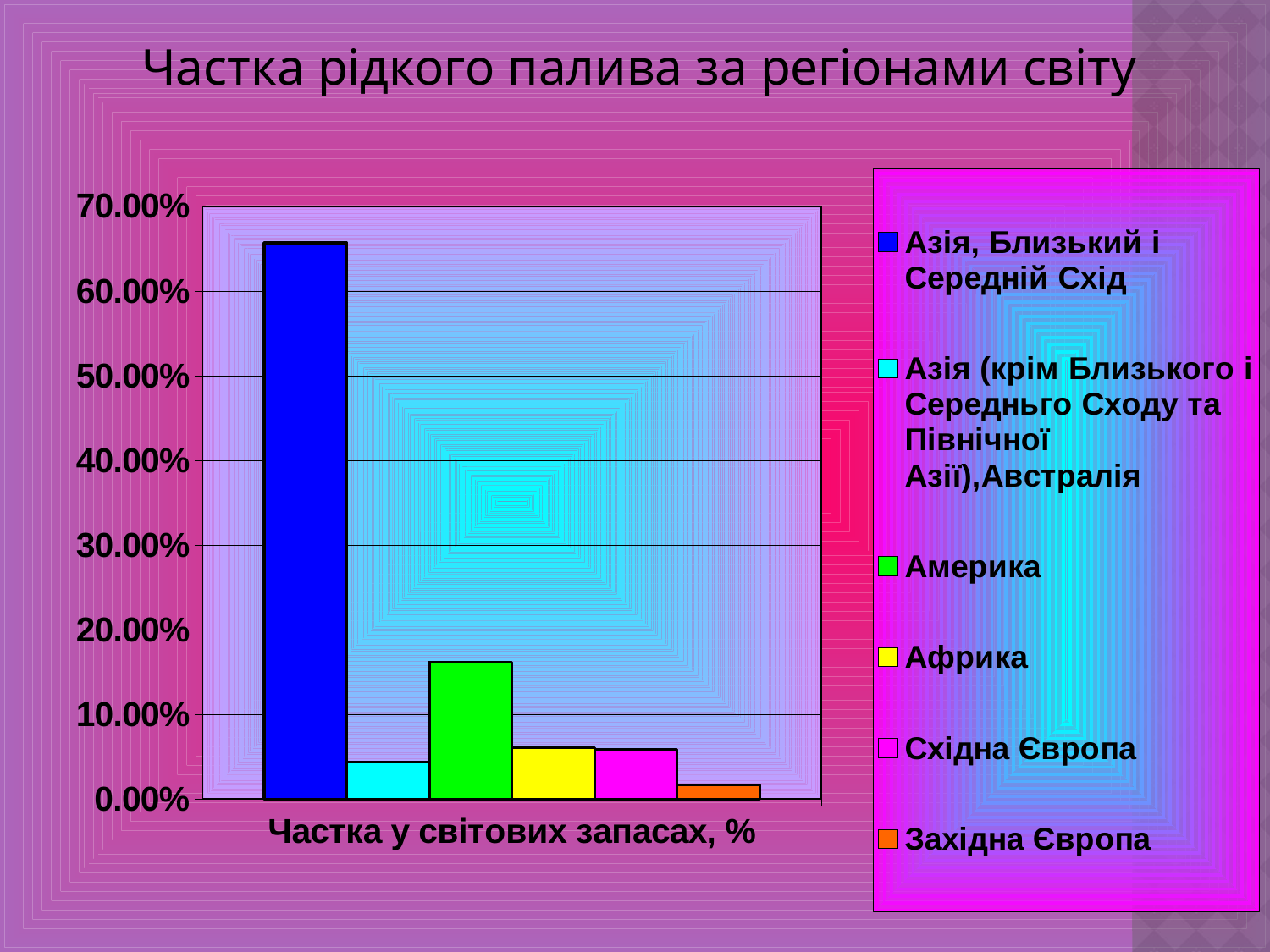
Which is larger, the value for Америка or the value for Африка? Америка Is the value for Африка greater or less than 10.00%? less What kind of chart is shown on the slide? Bar chart Is the value for Америка greater or less than 10.00%? greater Which is larger, the value for Азія, Близький і Середній Схід or the value for Америка? Азія, Близький і Середній Схід Which region has the lowest share in the chart? Західна Європа What is the title of the chart? Частка рідкого палива за регіонами світу How many series does the legend list? 6 Which region has the highest share in the chart? Азія, Близький і Середній Схід What is the label shown under the x axis of the chart? Частка у світових запасах, % Is the value for Азія, Близький і Середній Схід greater or less than 60.00%? greater How many bars are plotted in the chart? 6